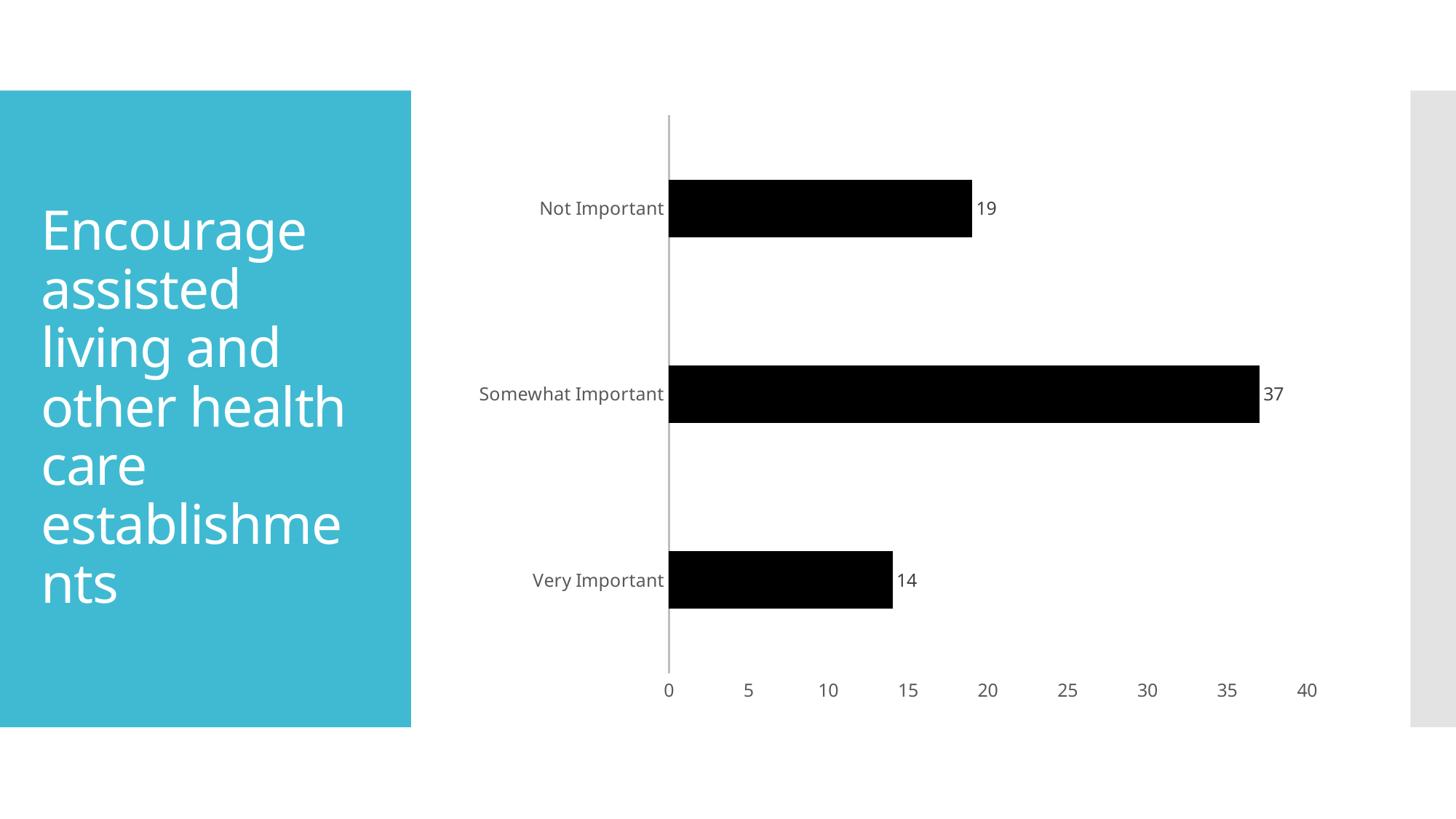
What kind of chart is shown on the slide? bar chart What is the difference between the values for Not Important and Very Important? 5 Which category has the lowest value? Very Important What is the difference between the values for Somewhat Important and Very Important? 23 What is the maximum value shown on the horizontal axis? 40 What is the value for Somewhat Important? 37 What is the value for Not Important? 19 How many categories are shown in the chart? 3 What is the value for Very Important? 14 Is the value for Somewhat Important greater or less than 30? greater Which category has the highest value? Somewhat Important Which is larger, the value for Not Important or the value for Very Important? Not Important